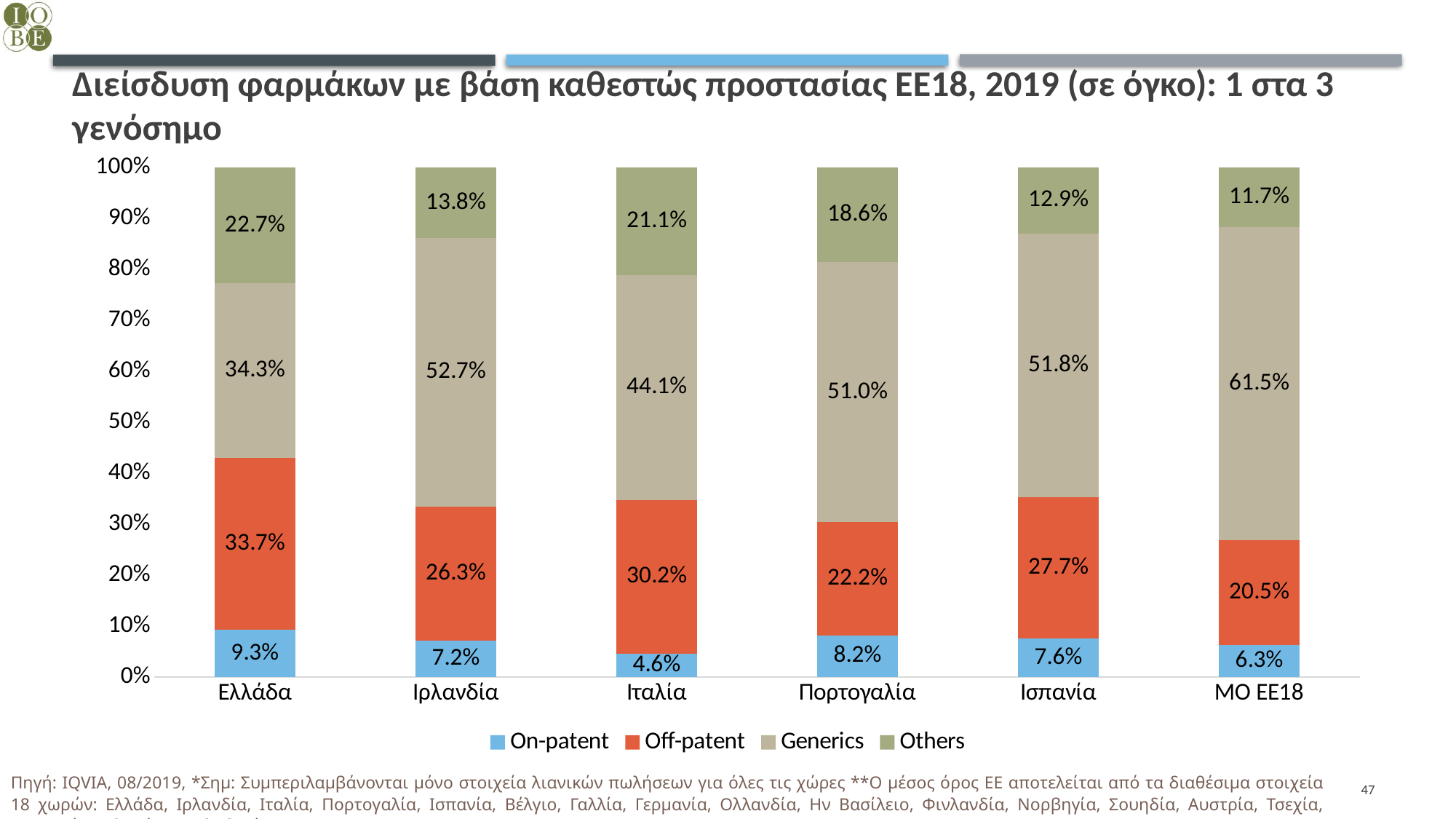
Which category has the lowest On-patent share? Ιταλία How many series does the legend list? 4 Which category has the highest Generics share? ΜΟ ΕΕ18 What is the Others share for Πορτογαλία? 18.6% What kind of chart is shown on the slide? Stacked bar chart What is the Off-patent share for ΜΟ ΕΕ18? 20.5% What is the On-patent share for Ιταλία? 4.6% Which is larger: the Others share for Ιρλανδία or for Ιταλία? Ιταλία Which category has the highest Off-patent share? Ελλάδα What is the Generics share for Ελλάδα? 34.3% How many categories are shown on the x axis? 6 What is the difference in Generics share between ΜΟ ΕΕ18 and Ελλάδα? 27.2 percentage points